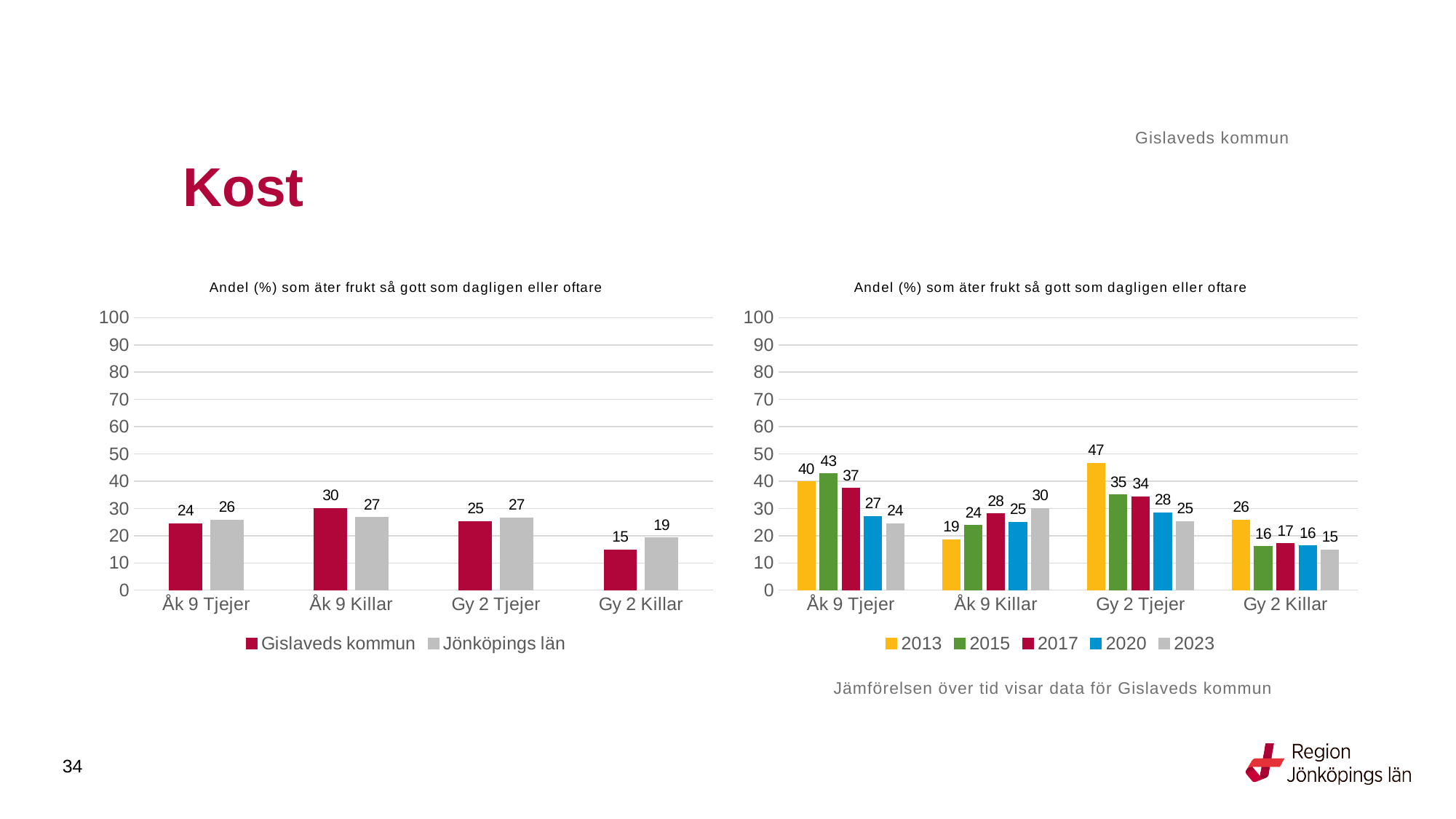
What kind of chart is the left chart? Bar chart In the left chart, what is the value for Jönköpings län for Gy 2 Killar? 19 In the right chart, which year has the highest value for Åk 9 Tjejer? 2015 In the left chart, how many series does the legend list? 2 In the right chart, what is the value for 2023 for Åk 9 Killar? 30 In the right chart, is the value for 2013 for Gy 2 Tjejer larger than the value for 2015 for Gy 2 Tjejer? Yes In the left chart, what is the value for Gislaveds kommun for Åk 9 Killar? 30 In the left chart, which category has the lowest value for Gislaveds kommun? Gy 2 Killar In the right chart, what is the value for 2013 for Gy 2 Tjejer? 47 In the left chart, what is the difference between Jönköpings län and Gislaveds kommun for Gy 2 Killar? 4 In the right chart, how many series does the legend list? 5 In the right chart, what is the difference between the 2013 and 2023 values for Gy 2 Killar? 11